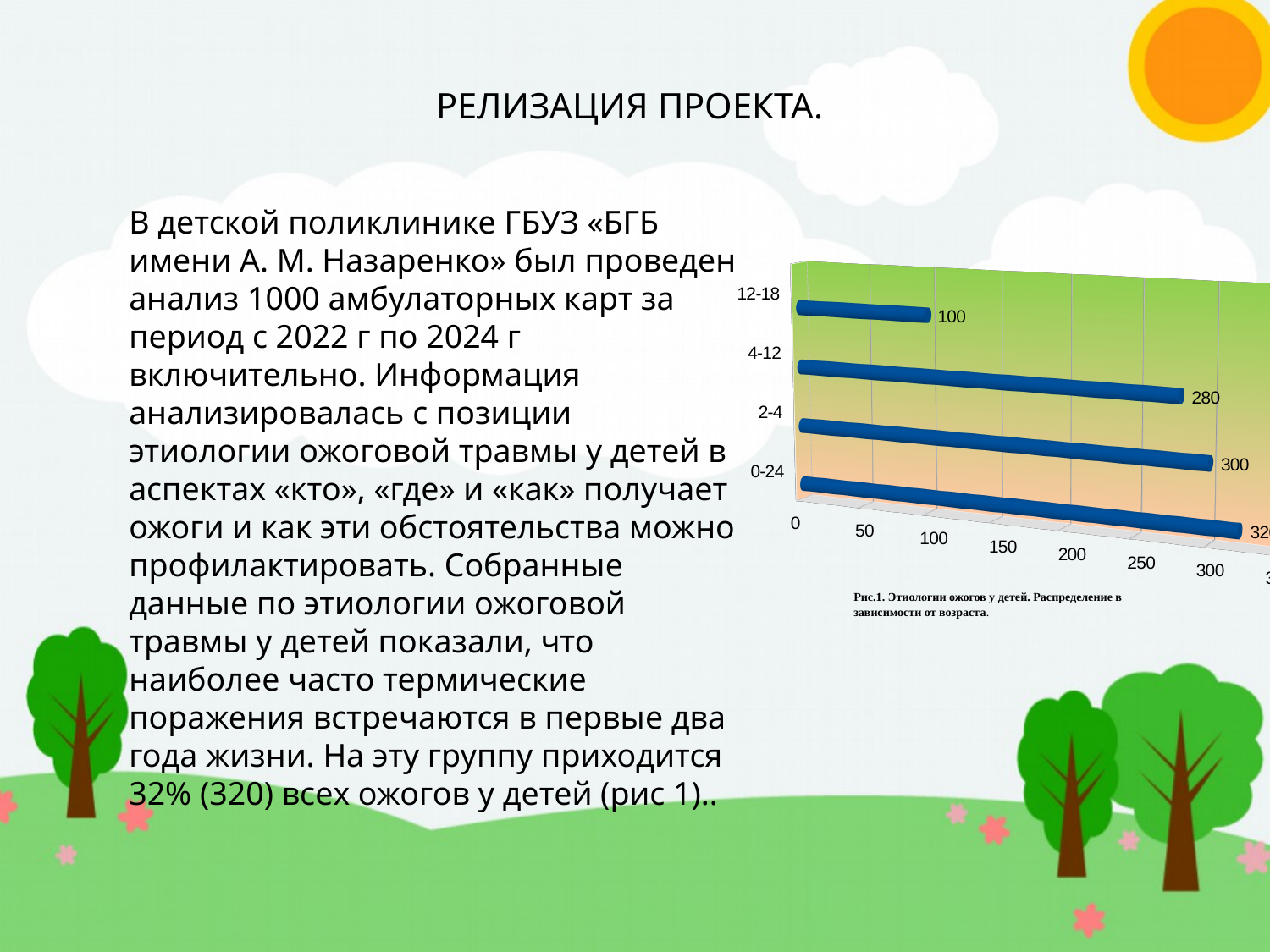
What is the difference between the values for 2-4 and 4-12? 20 Is the value for 0-24 greater or less than 300? greater Which category has the lowest value? 12-18 What is the value for the 4-12 category? 280 What is the value for the 12-18 category? 100 Which is larger, the value for 2-4 or the value for 12-18? 2-4 What is the figure caption below the chart? Рис.1. Этиологии ожогов у детей. Распределение в зависимости от возраста. How many categories are shown in the chart? 4 What is the difference between the values for 4-12 and 12-18? 180 What kind of chart is shown on the slide? bar chart What is the value for the 2-4 category? 300 Which category has the highest value? 0-24